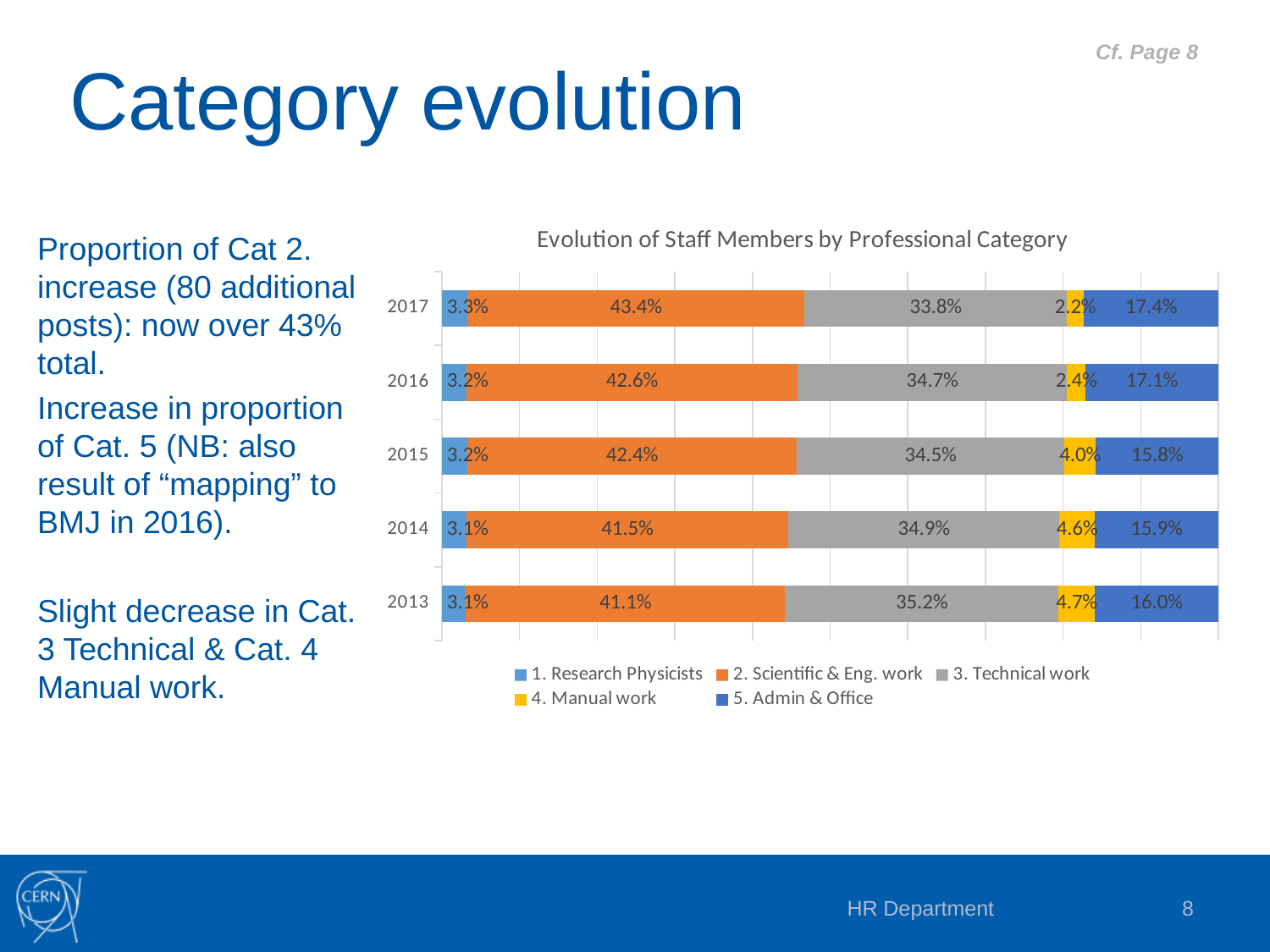
What is the value for 2. Scientific & Eng. work in 2017? 43.4% What is the value for 4. Manual work in 2015? 4.0% What is the value for 5. Admin & Office in 2016? 17.1% What is the value for 3. Technical work in 2013? 35.2% Which is larger: 3. Technical work in 2014 or 3. Technical work in 2017? 3. Technical work in 2014 In which year is the value for 2. Scientific & Eng. work highest? 2017 What is the title of the chart? Evolution of Staff Members by Professional Category What is the difference between the 2. Scientific & Eng. work values for 2017 and 2013? 2.3% What kind of chart is shown? Stacked bar chart How many series does the legend list? 5 In which year is the value for 4. Manual work lowest? 2017 How many years are shown on the chart? 5